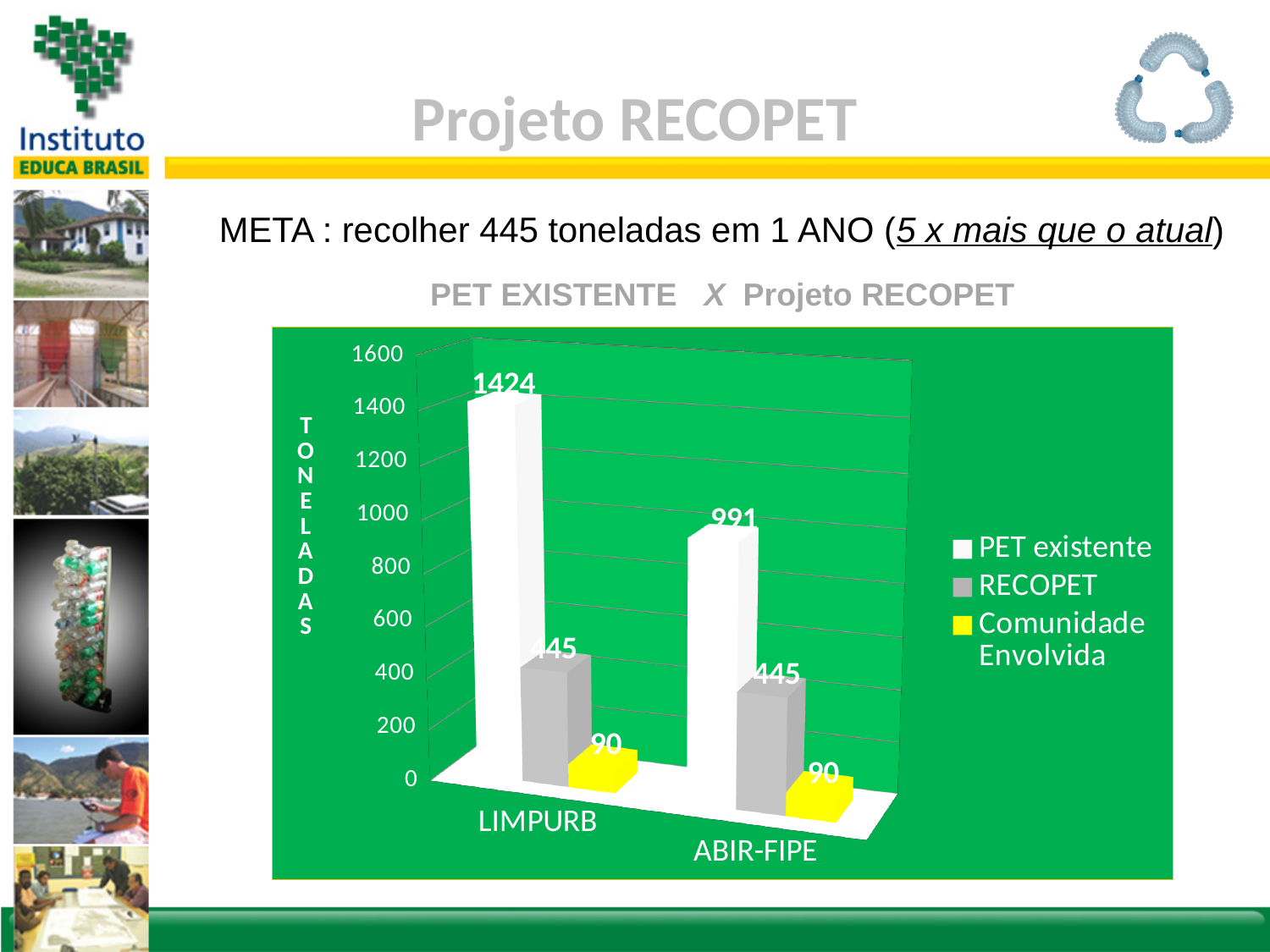
What is the value of PET existente for LIMPURB? 1424 What kind of chart is shown on the slide? bar chart How many categories are shown on the x axis? 2 What is the Comunidade Envolvida value for LIMPURB? 90 Which series has the lowest value for ABIR-FIPE? Comunidade Envolvida Is the PET existente value for ABIR-FIPE greater or less than 1000? less What is the RECOPET value for ABIR-FIPE? 445 What is the value of PET existente for ABIR-FIPE? 991 What is the title of the chart? PET EXISTENTE X Projeto RECOPET What is the difference between the PET existente values for LIMPURB and ABIR-FIPE? 433 How many series does the legend list? 3 Which category has the higher PET existente value? LIMPURB